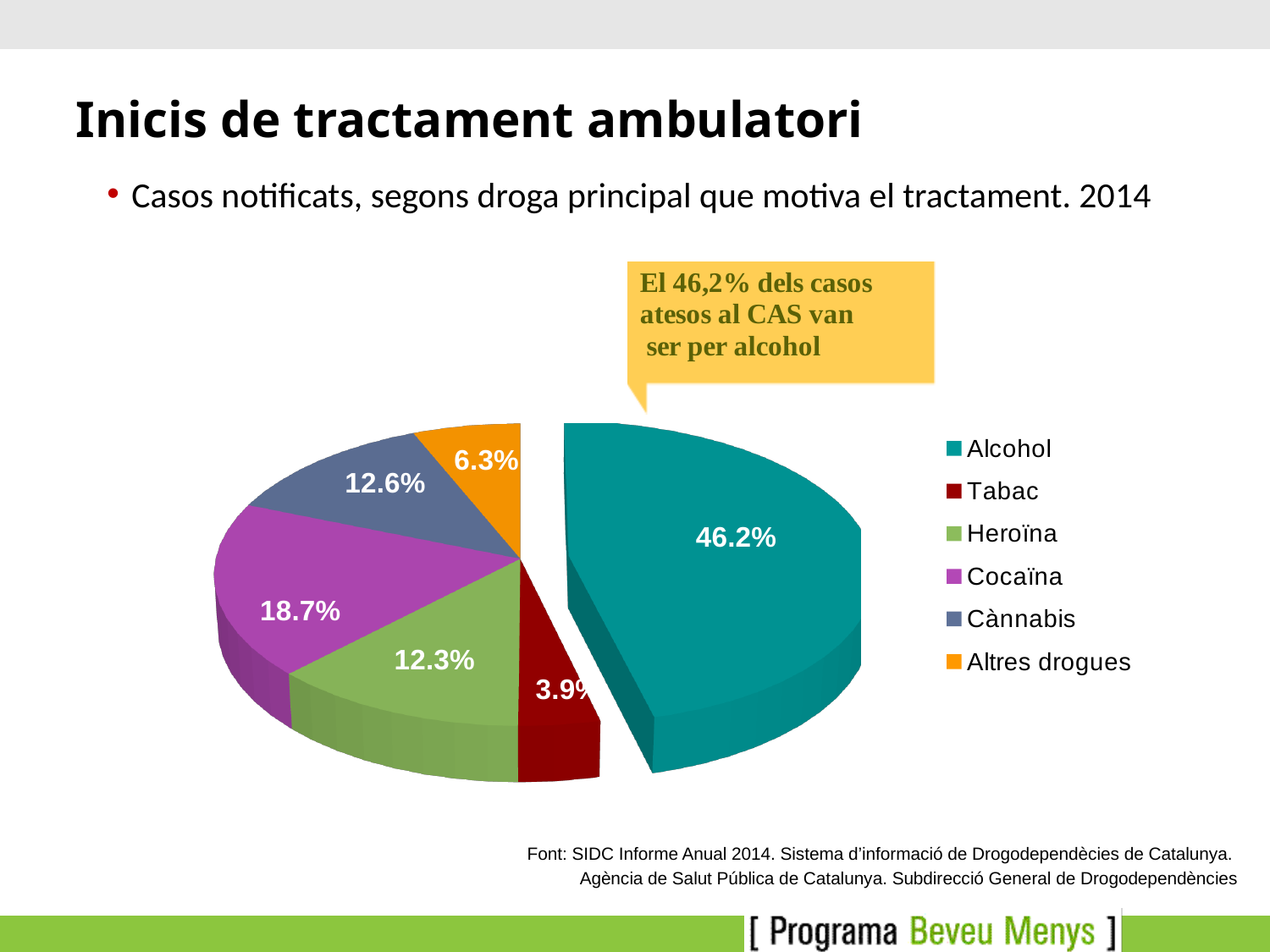
How many categories does the pie chart show? 6 What share of the pie does Alcohol represent? 46.2% Which category has the smallest slice of the pie? Tabac What kind of chart is shown on the slide? Pie chart What percentage is shown for Altres drogues? 6.3% Which is larger, the share for Cocaïna or the share for Heroïna? Cocaïna Which category has the largest slice of the pie? Alcohol What percentage is shown for Tabac? 3.9% What is the difference in percentage points between Alcohol and Cocaïna? 27.5 What is the difference in percentage points between Cocaïna and Altres drogues? 12.4 What percentage is shown for Cocaïna? 18.7% Which category is shown in orange in the legend? Altres drogues